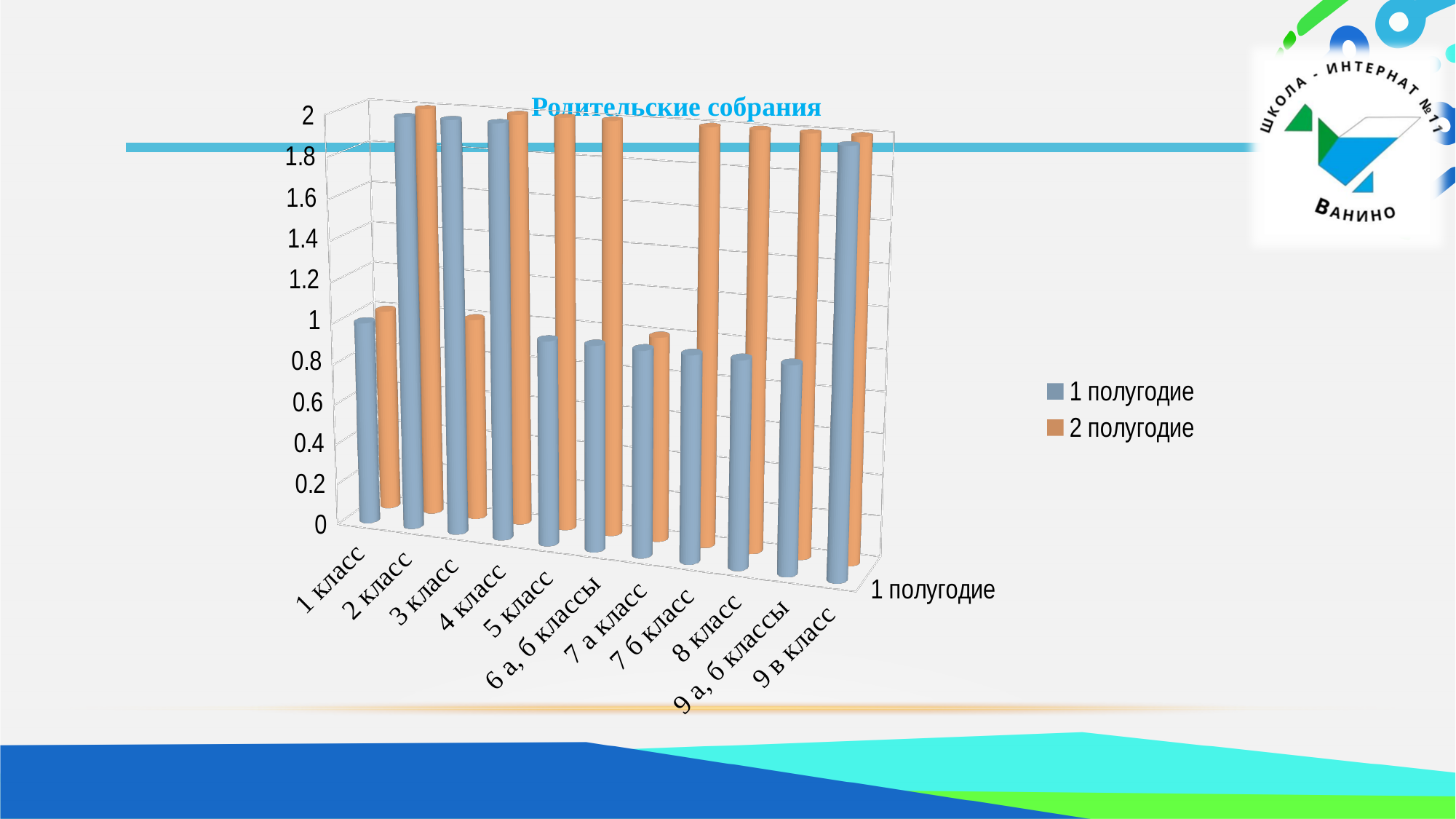
Is the value for 5 класс in 1 полугодие greater or less than 1.5? less Is the value for 3 класс in 2 полугодие greater or less than 1.5? less What kind of chart is shown on the slide? bar chart Is the value for 8 класс in 2 полугодие greater or less than 1.5? greater How many class categories are shown on the x axis? 11 What is the title of the chart? Родительские собрания Which series is shown in orange according to the legend? 2 полугодие How many series does the legend list? 2 For 5 класс, which series has the larger value, 1 полугодие or 2 полугодие? 2 полугодие For 3 класс, which series has the larger value, 1 полугодие or 2 полугодие? 1 полугодие